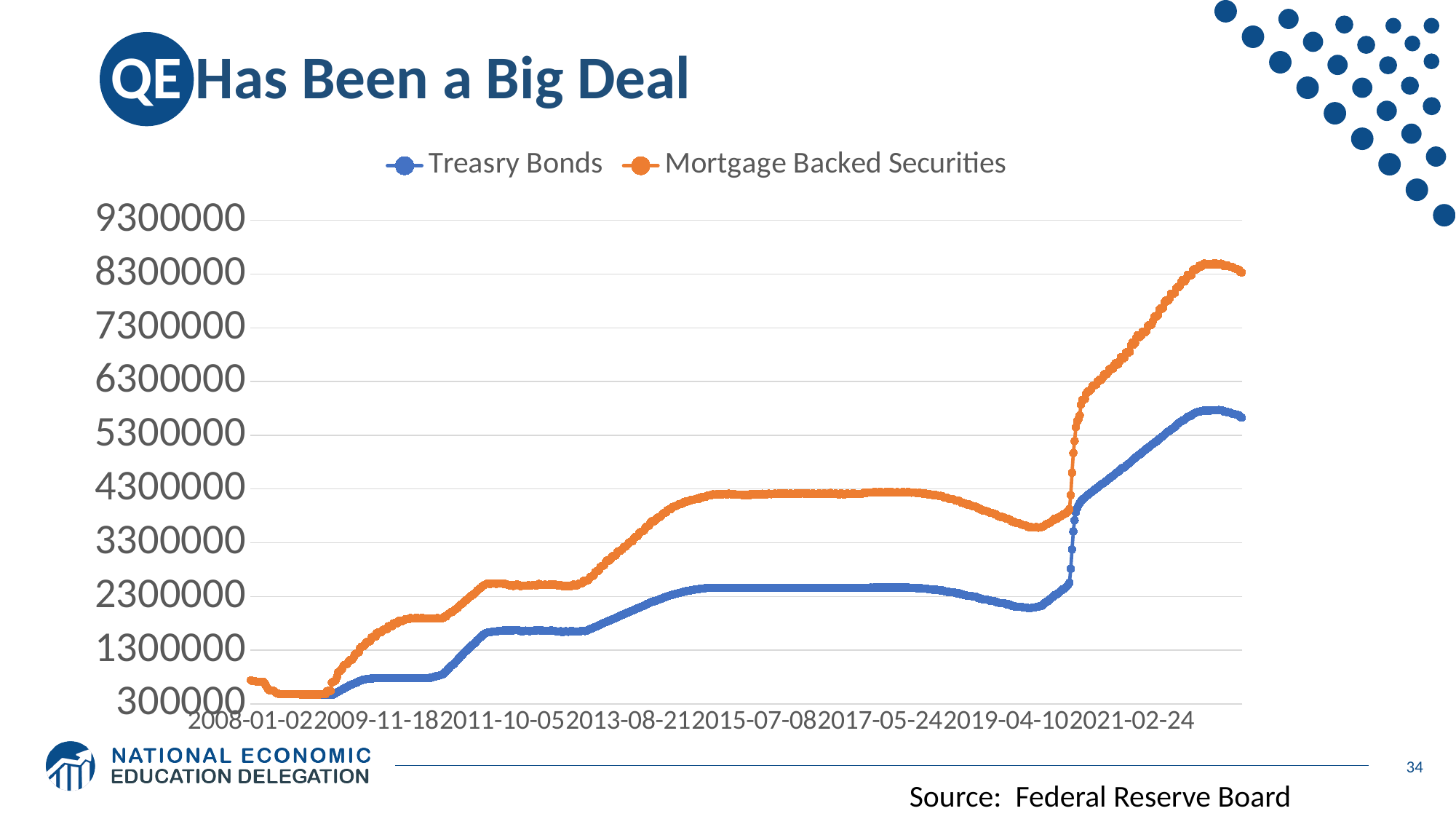
Is the highest value reached by Treasry Bonds greater or less than 5300000? greater Is the value for Treasry Bonds at 2017-05-24 greater or less than 3300000? less Which series is plotted in orange? Mortgage Backed Securities Is the value for Treasry Bonds at 2008-01-02 greater or less than 1300000? less Do the values for Treasry Bonds generally rise or fall from left to right along the x axis? Rise What kind of chart is shown on the slide? Line chart What are the two series named in the legend? Treasry Bonds and Mortgage Backed Securities How many date labels are shown on the x axis? 8 How many series does the legend list? 2